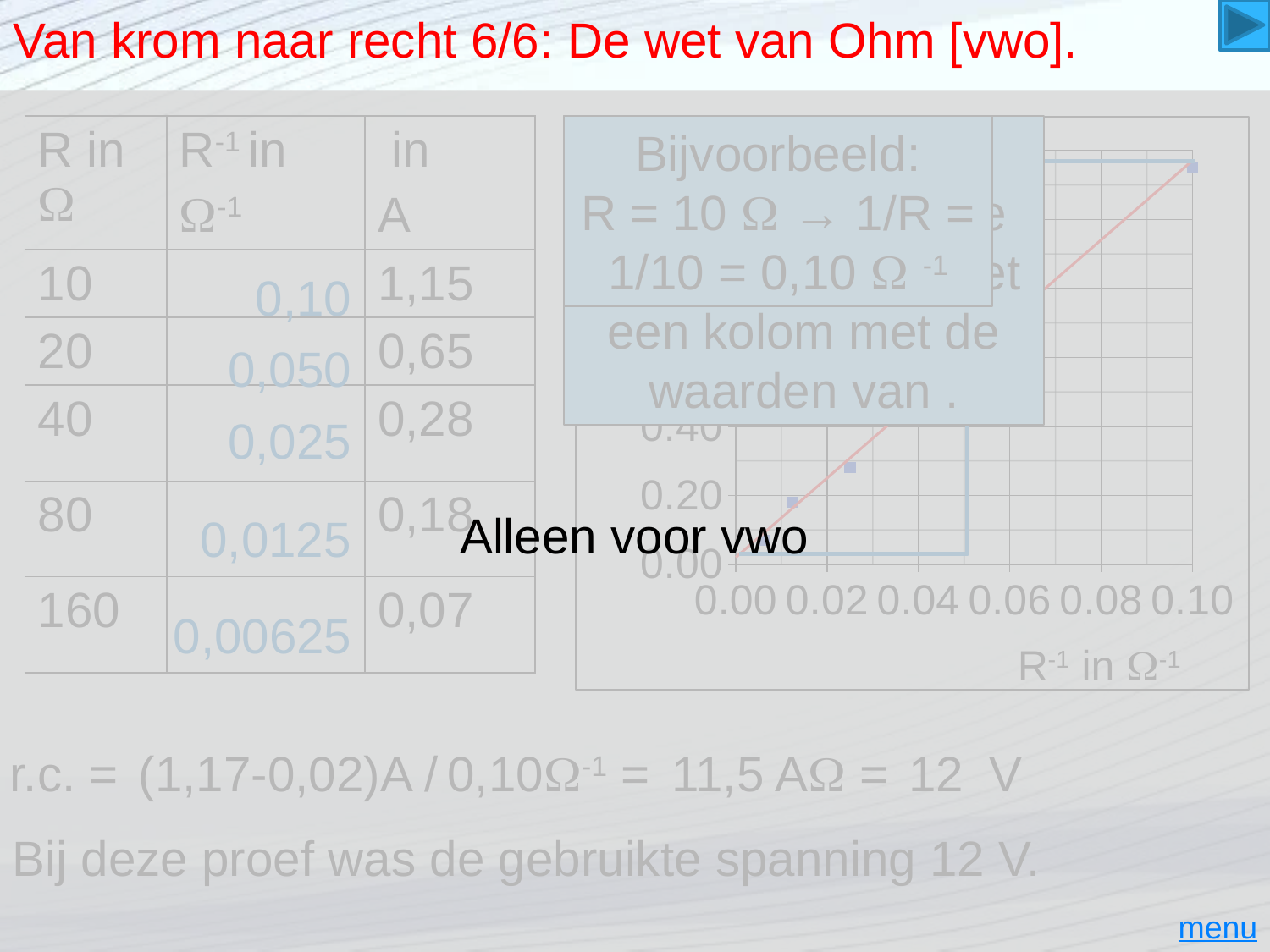
Is the plotted value at R⁻¹ = 0.10 greater or less than 0.40? greater What is the label of the x axis of the chart? R⁻¹ in Ω⁻¹ What is the largest tick value shown on the x axis of the chart? 0.10 Do the plotted values rise or fall as R⁻¹ increases along the x axis? rise What kind of chart is shown on the right of the slide? scatter chart